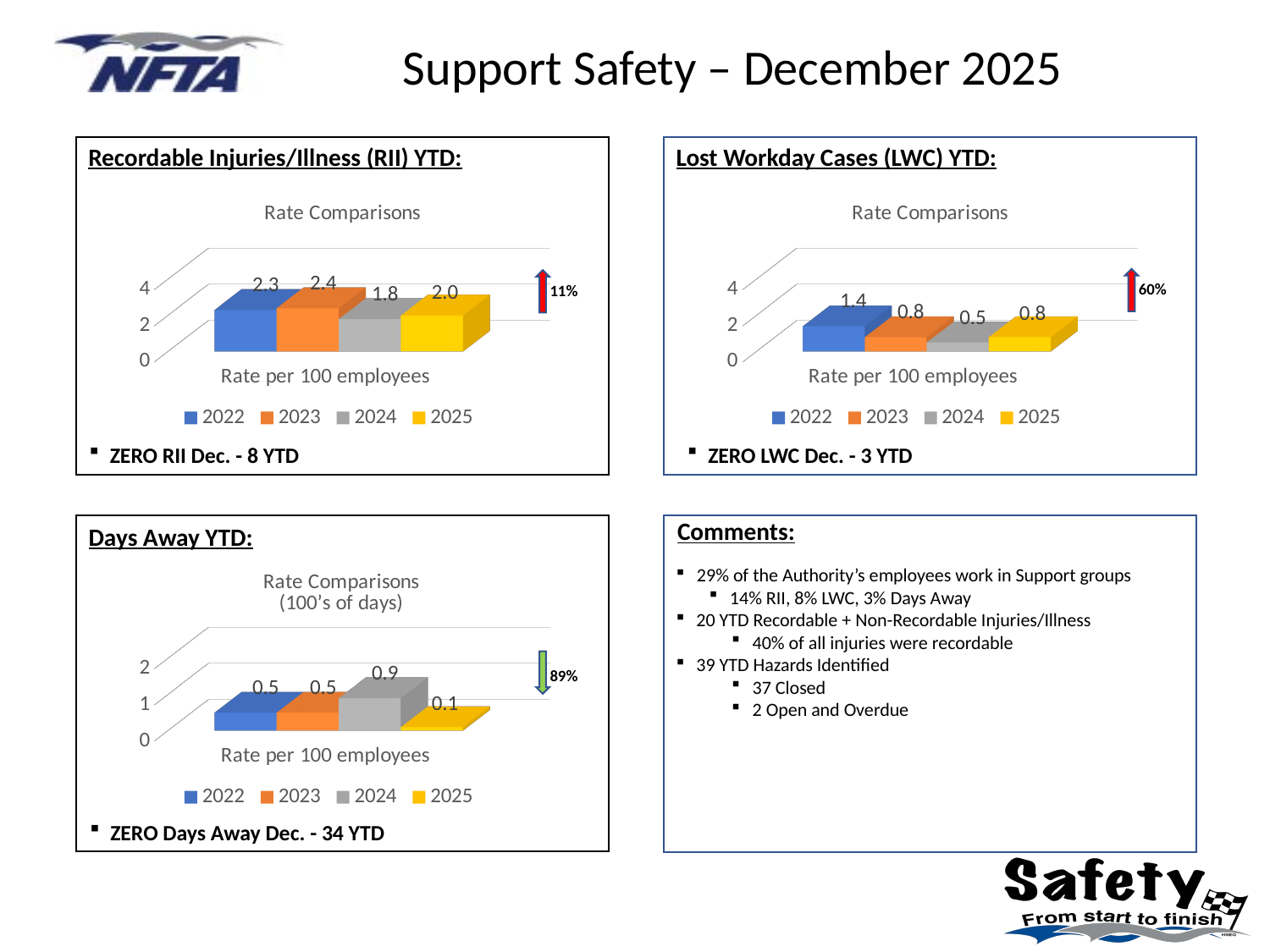
In the Days Away YTD chart, what is the value for 2024? 0.9 In the Recordable Injuries/Illness (RII) YTD chart, what is the value for 2025? 2.0 In the Recordable Injuries/Illness (RII) YTD chart, what is the difference between the 2023 and 2024 values? 0.6 In the Lost Workday Cases (LWC) YTD chart, which year has the lowest rate? 2024 In the Lost Workday Cases (LWC) YTD chart, is the value for 2022 larger or smaller than the value for 2025? larger In the Recordable Injuries/Illness (RII) YTD chart, which year has the highest rate? 2023 In the Lost Workday Cases (LWC) YTD chart, what is the value for 2022? 1.4 What is the x-axis category label shown in the Recordable Injuries/Illness (RII) YTD chart? Rate per 100 employees In the Days Away YTD chart, what is the difference between the 2024 and 2025 values? 0.8 How many series does the legend list in the Days Away YTD chart? 4 In the Days Away YTD chart, which year has the lowest rate? 2025 What kind of chart is the Lost Workday Cases (LWC) YTD chart? bar chart